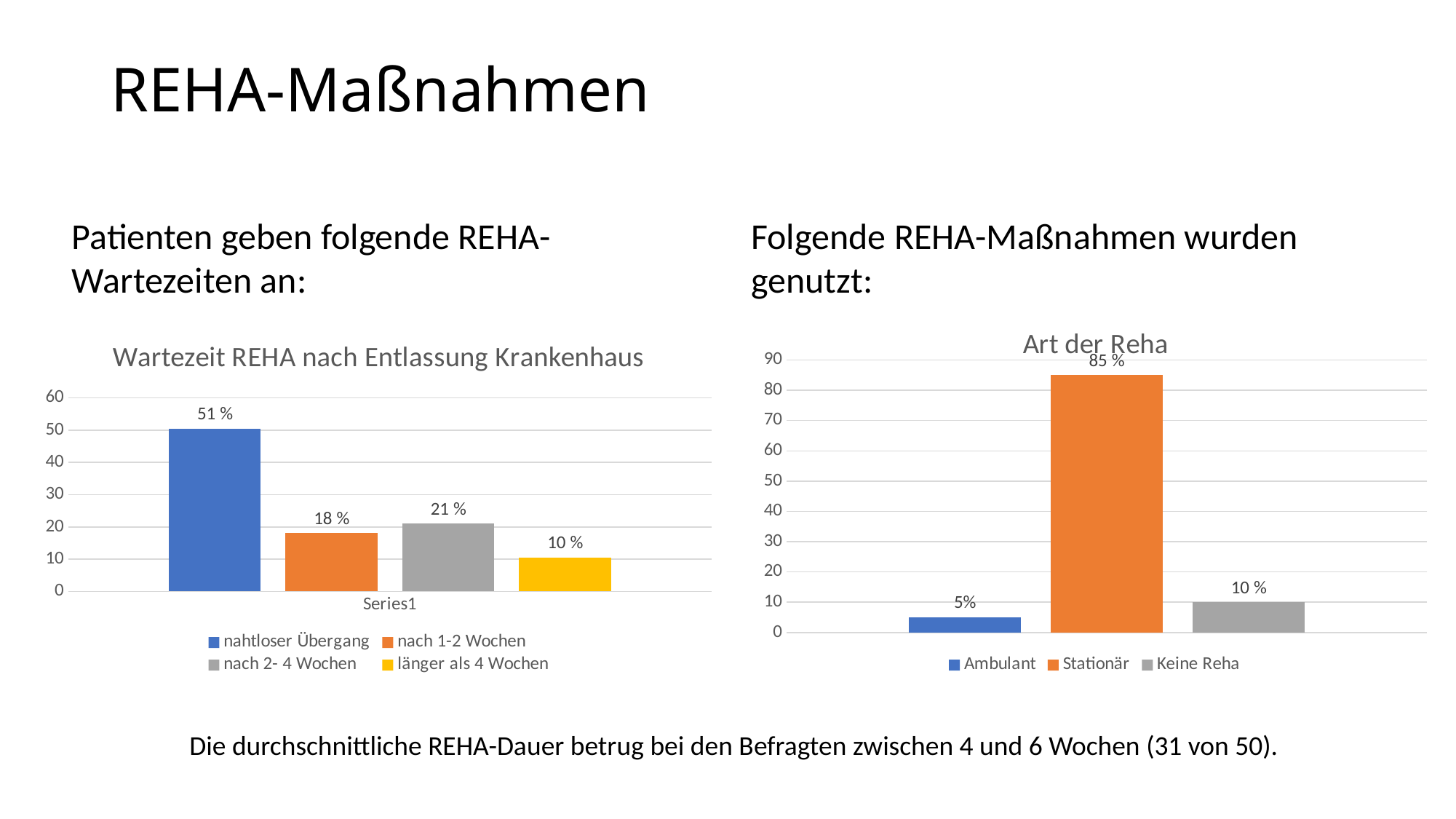
In the chart 'Art der Reha', what is the difference between 'Stationär' and 'Keine Reha'? 75 % What colour is the bar for 'Stationär' in the chart 'Art der Reha'? orange In the chart 'Art der Reha', what is the value for 'Stationär'? 85 % In the chart 'Art der Reha', which category has the highest value? Stationär In the chart 'Wartezeit REHA nach Entlassung Krankenhaus', which category has the lowest value? länger als 4 Wochen In the chart 'Wartezeit REHA nach Entlassung Krankenhaus', what is the value for 'nahtloser Übergang'? 51 % In the chart 'Art der Reha', what is the value for 'Ambulant'? 5% In the chart 'Wartezeit REHA nach Entlassung Krankenhaus', what is the value for 'nach 2- 4 Wochen'? 21 % How many entries does the legend of the chart 'Wartezeit REHA nach Entlassung Krankenhaus' list? 4 In the chart 'Wartezeit REHA nach Entlassung Krankenhaus', which is larger: 'nach 1-2 Wochen' or 'nach 2- 4 Wochen'? nach 2- 4 Wochen What kind of chart is 'Art der Reha'? bar chart In the chart 'Wartezeit REHA nach Entlassung Krankenhaus', what is the difference between 'nahtloser Übergang' and 'nach 1-2 Wochen'? 33 %